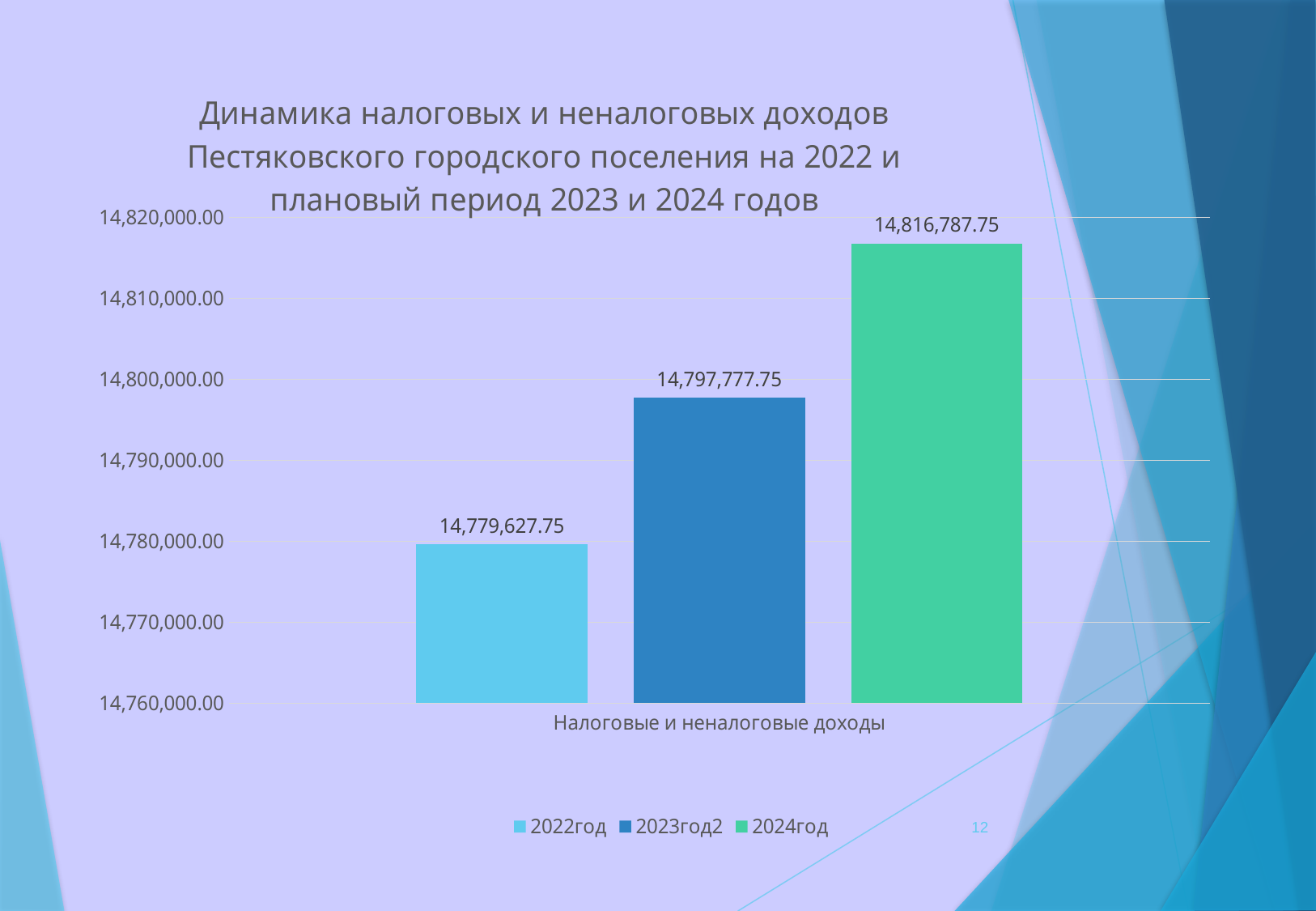
How many series does the legend list? 3 Is the value for 2023год2 greater or less than 14,790,000.00? greater What is the value for the 2024год series? 14,816,787.75 What is the difference between the 2023год2 value and the 2022год value? 18,150.00 Which is larger, the value for 2022год or the value for 2024год? 2024год Which series has the lowest value? 2022год What kind of chart is shown on the slide? bar chart What is the value for the 2023год2 series? 14,797,777.75 What is the category label shown on the x axis? Налоговые и неналоговые доходы What is the value for the 2022год series? 14,779,627.75 What is the difference between the 2024год value and the 2023год2 value? 19,010.00 Which series has the highest value? 2024год